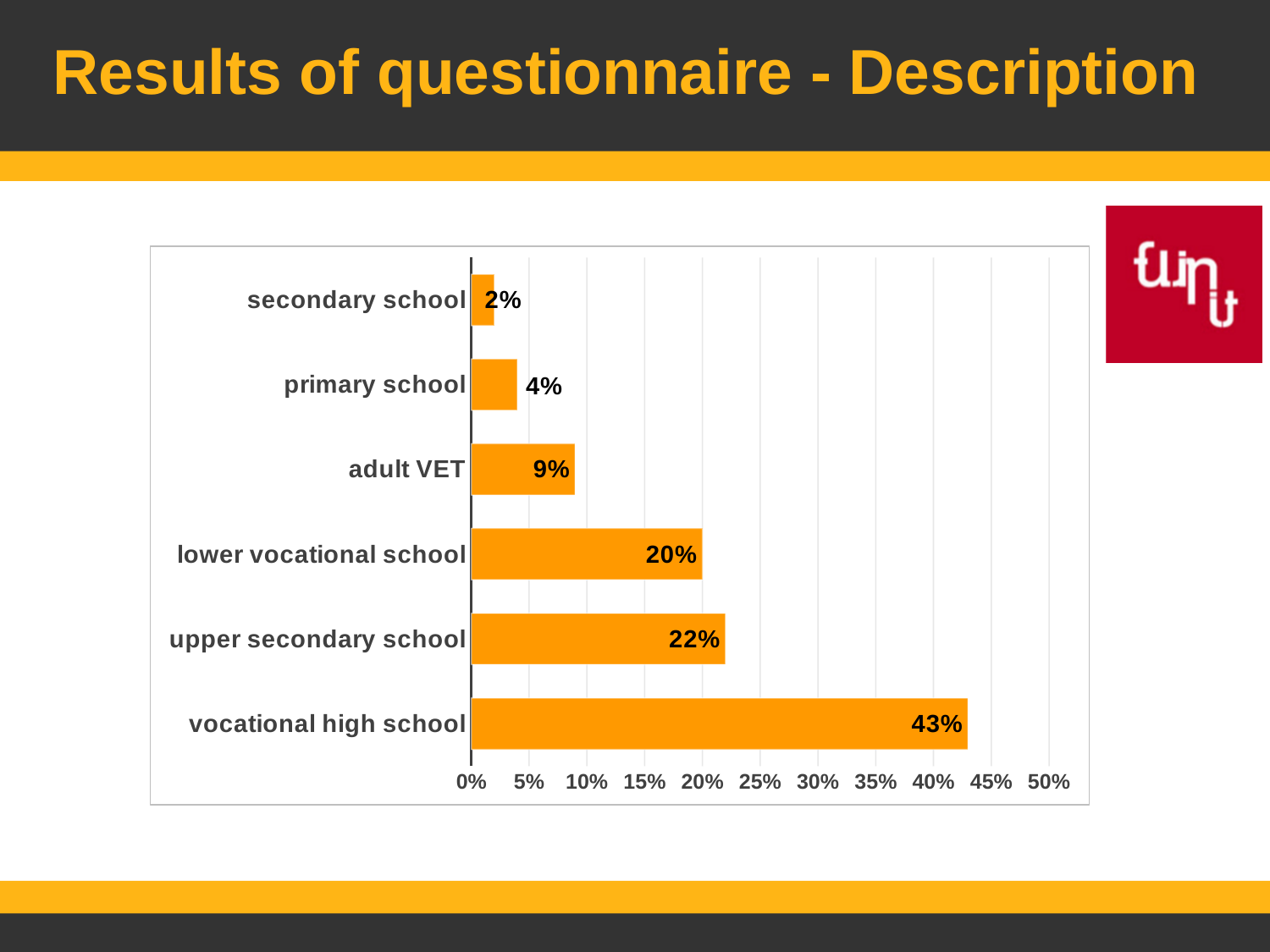
What colour are the bars in the chart? orange What is the value for adult VET? 9% Is the value for upper secondary school greater or less than 25%? less Which category has the lowest value? secondary school Which is larger, the value for primary school or the value for adult VET? adult VET How many categories are shown in the chart? 6 What is the value for lower vocational school? 20% What is the value for vocational high school? 43% Which category has the highest value? vocational high school What is the difference between the values for upper secondary school and lower vocational school? 2% What is the difference between the values for vocational high school and adult VET? 34% What kind of chart is shown on the slide? bar chart